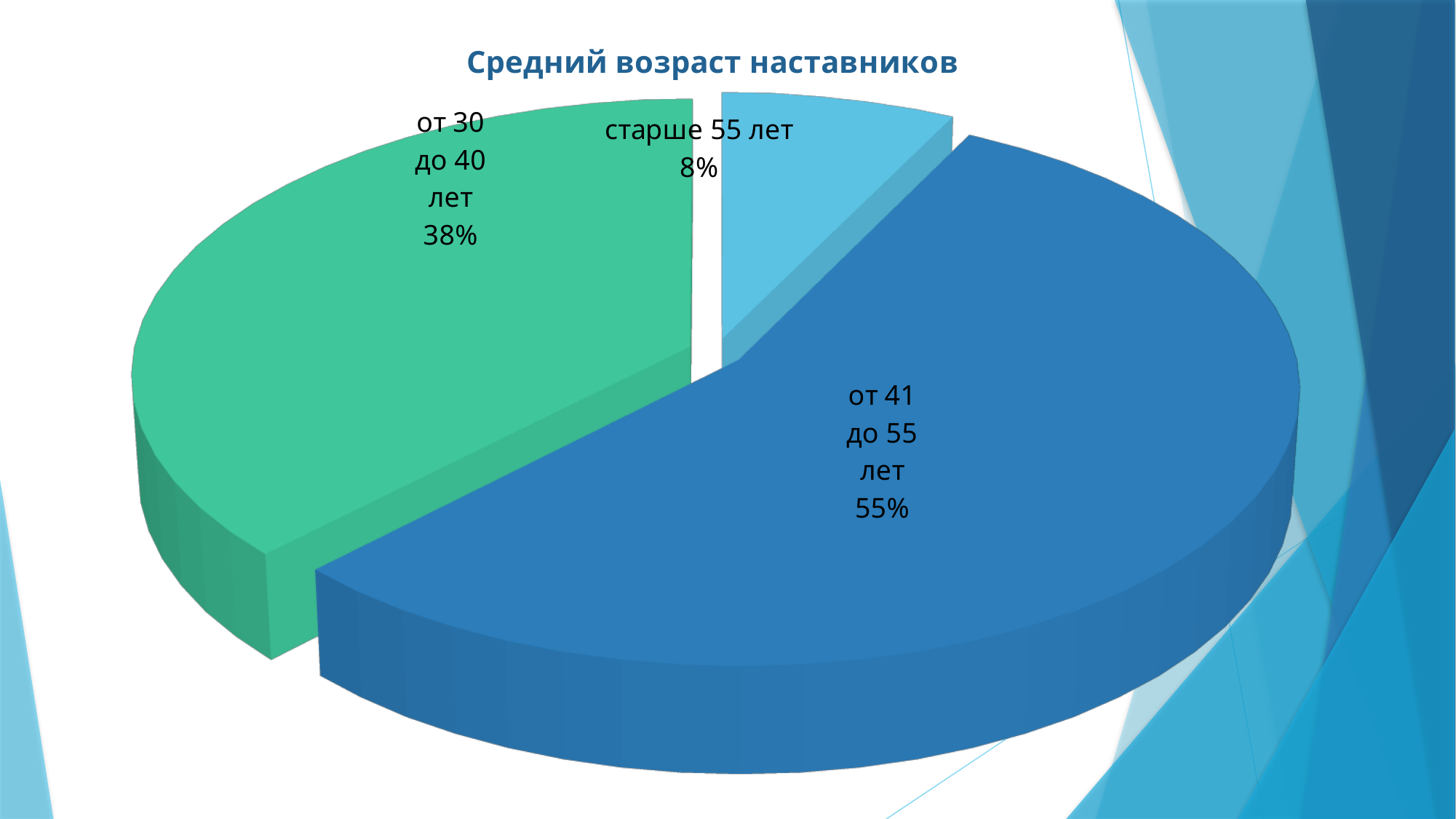
What is the title of the chart? Средний возраст наставников Which age group has the smallest share of the pie? старше 55 лет How many slices does the pie chart have? 3 What share of the pie is labelled "старше 55 лет"? 8% What is the difference in percentage points between the "от 41 до 55 лет" slice and the "от 30 до 40 лет" slice? 17 What share of the pie is labelled "от 30 до 40 лет"? 38% What type of chart is shown on the slide? pie chart What colour is the slice labelled "от 30 до 40 лет"? green Which age group has the largest share of the pie? от 41 до 55 лет Which slice is larger: "от 30 до 40 лет" or "старше 55 лет"? от 30 до 40 лет What is the difference in percentage points between the "от 30 до 40 лет" slice and the "старше 55 лет" slice? 30 What share of the pie is labelled "от 41 до 55 лет"? 55%